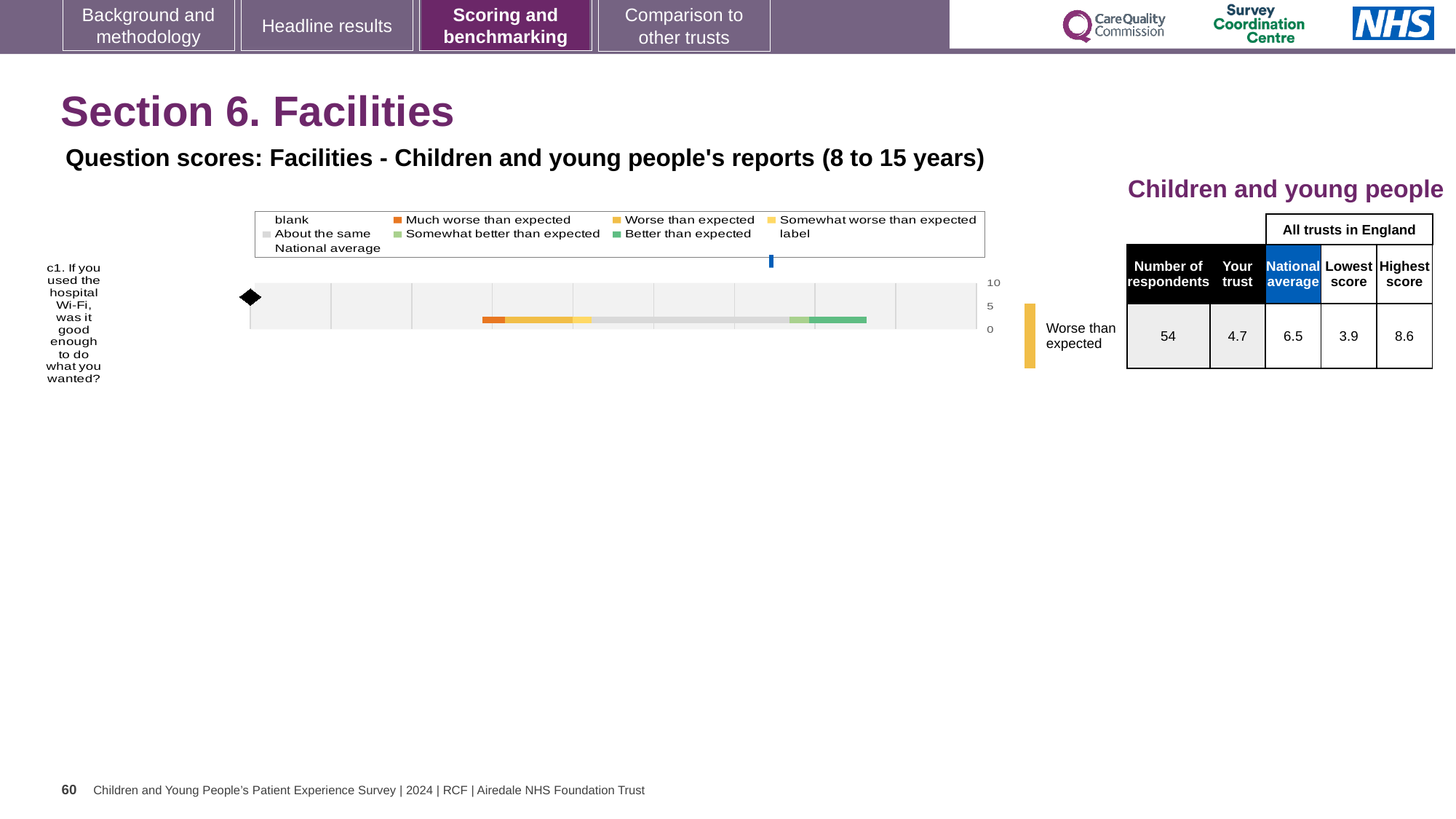
How many survey questions are plotted in the chart? 1 What is the national average score for question c1 in the table? 6.5 What is the lowest score among all trusts in England for question c1? 3.9 What is the difference between the highest score and the lowest score for question c1? 4.7 Which is larger for question c1: the 'Your trust' score or the national average? National average According to the table, how many respondents answered question c1 about the hospital Wi-Fi? 54 What is the 'Your trust' score for question c1 in the table? 4.7 What is the highest score among all trusts in England for question c1? 8.6 What benchmark category is question c1 assigned on the slide? Worse than expected Which colour in the chart legend represents 'Much worse than expected'? Orange By how much does the national average exceed the 'Your trust' score for question c1? 1.8 What kind of chart is shown on the slide? bar chart